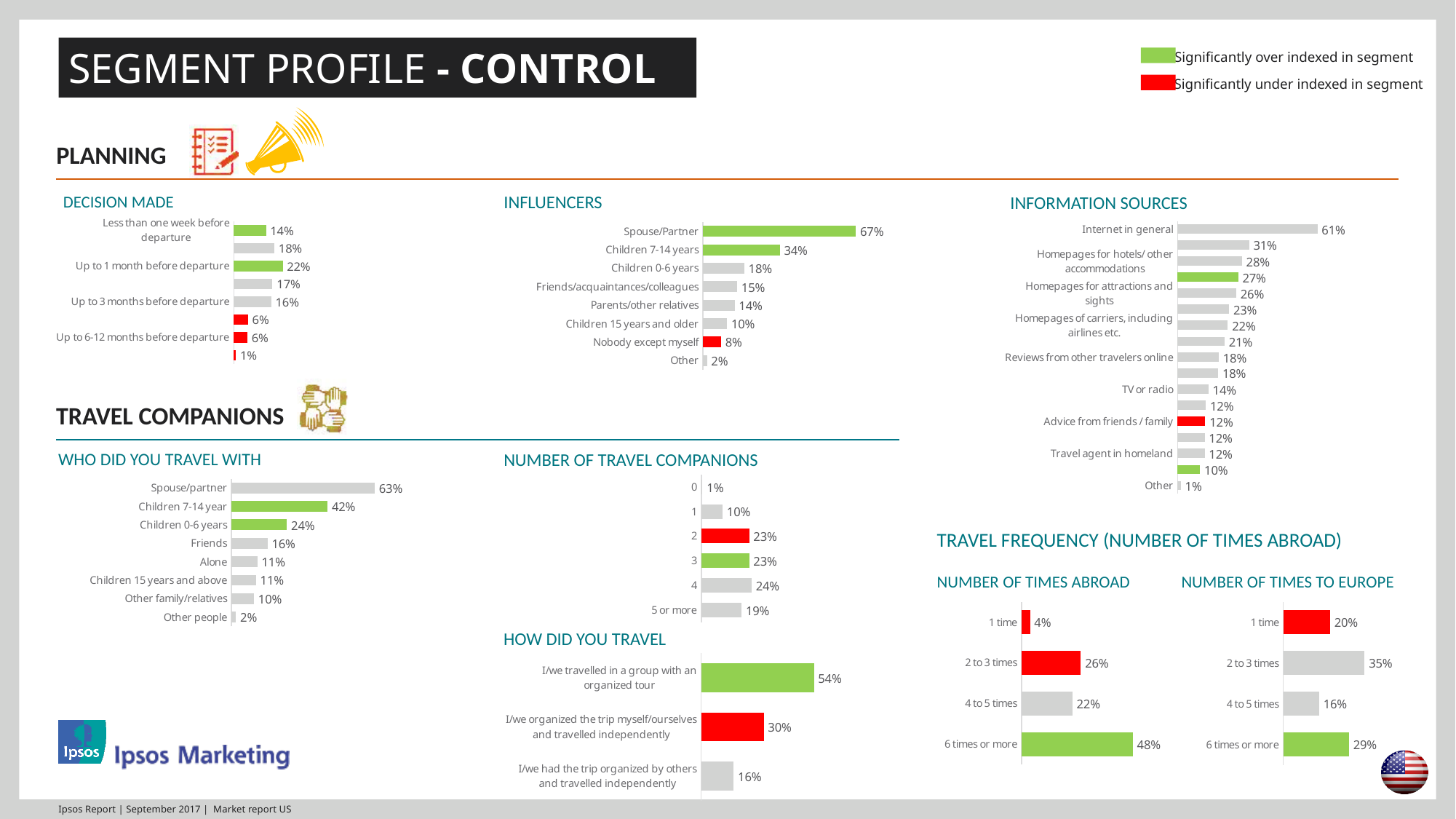
In the Who Did You Travel With chart, what is the difference between Spouse/partner and Children 0-6 years? 39 percentage points In the Number of Times to Europe chart, which is larger: 2 to 3 times or 6 times or more? 2 to 3 times In the Who Did You Travel With chart, which category has the highest value? Spouse/partner In the Influencers chart, what is the value for Spouse/Partner? 67% In the Number of Times Abroad chart, which category has the highest value? 6 times or more What type of chart is the Influencers chart? Bar chart In the Influencers chart, which category has the lowest value? Other How many categories are shown in the Number of Travel Companions chart? 6 In the How Did You Travel chart, what is the value for 'I/we organized the trip myself/ourselves and travelled independently'? 30% In the Who Did You Travel With chart, what is the value for Children 7-14 year? 42% In the Information Sources chart, what is the value for Internet in general? 61% In the Number of Travel Companions chart, what is the value for 4? 24%